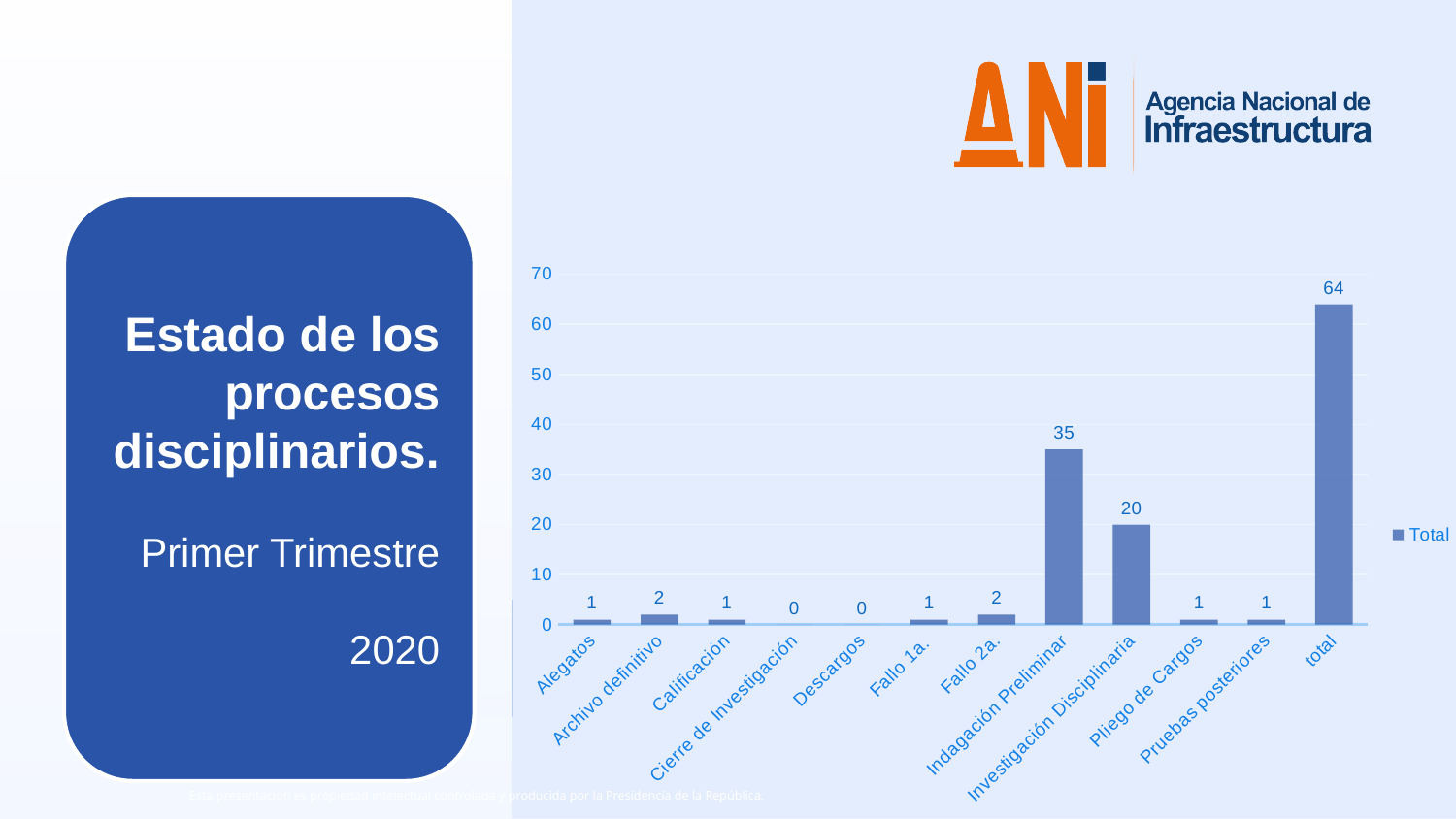
Which is larger, the value for Fallo 2a. or the value for Fallo 1a.? Fallo 2a. What is the name of the series shown in the legend? Total What is the difference between the values for Indagación Preliminar and Investigación Disciplinaria? 15 What is the value for Archivo definitivo? 2 How many series does the legend list? 1 Which category has the highest value in the chart? total What is the value shown for the 'total' bar? 64 What is the value for Indagación Preliminar? 35 What is the value for Investigación Disciplinaria? 20 How many categories are shown on the x axis? 12 What kind of chart is shown on the slide? Bar chart Excluding the 'total' bar, which category has the highest value? Indagación Preliminar